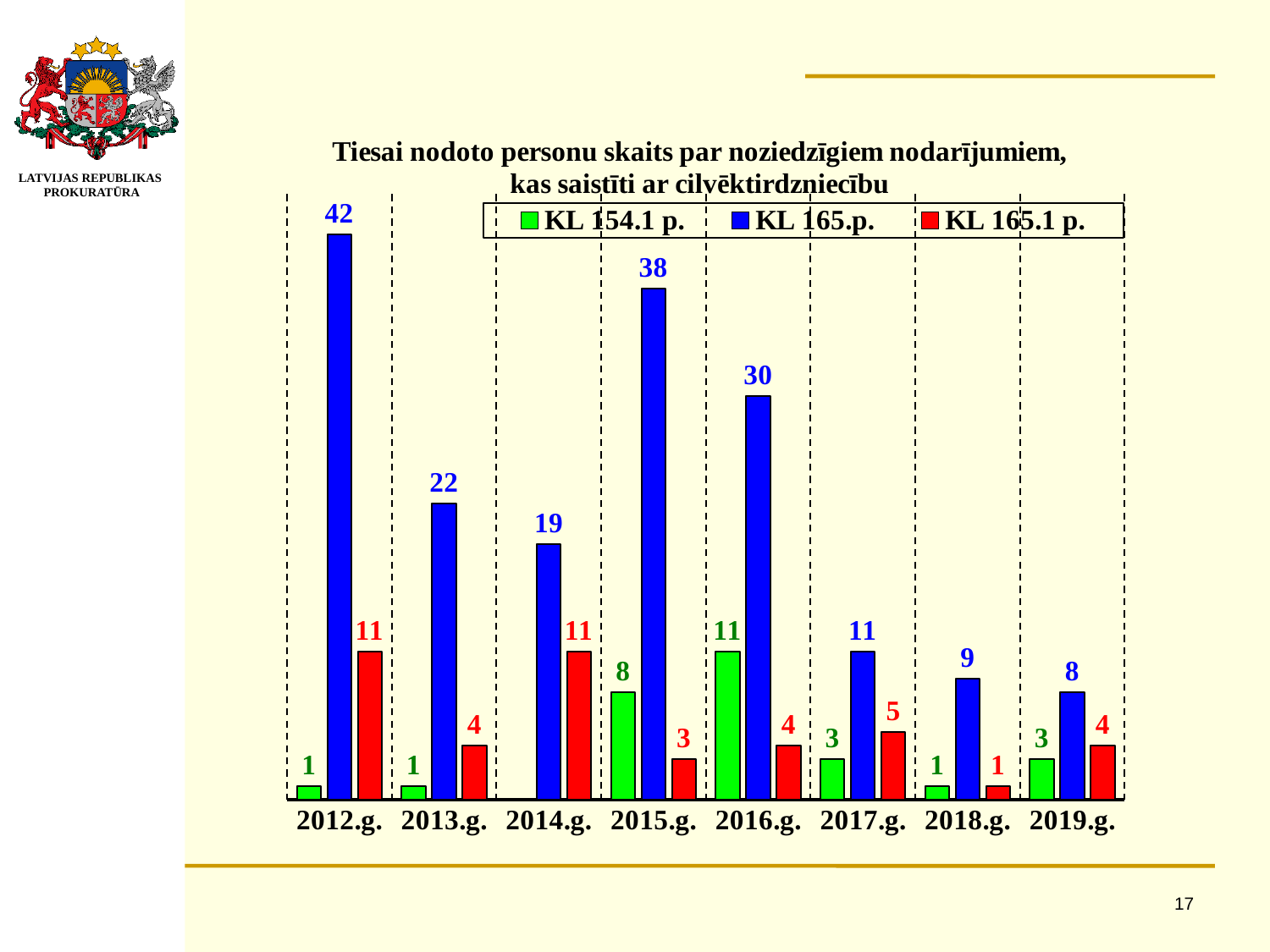
What kind of chart is shown on the slide? Bar chart In which year is the value for KL 165.p. highest? 2012.g. Which is larger in 2017.g., the value for KL 154.1 p. or the value for KL 165.1 p.? KL 165.1 p. In which year is the value for KL 165.p. lowest? 2019.g. What is the value for KL 154.1 p. in 2016.g.? 11 What is the value for KL 165.1 p. in 2014.g.? 11 What is the value for KL 165.p. in 2012.g.? 42 How many years are shown on the x axis? 8 Which colour represents KL 165.1 p. in the chart? Red What is the value for KL 165.p. in 2019.g.? 8 What is the difference between the KL 165.p. values for 2015.g. and 2016.g.? 8 How many series does the legend list? 3